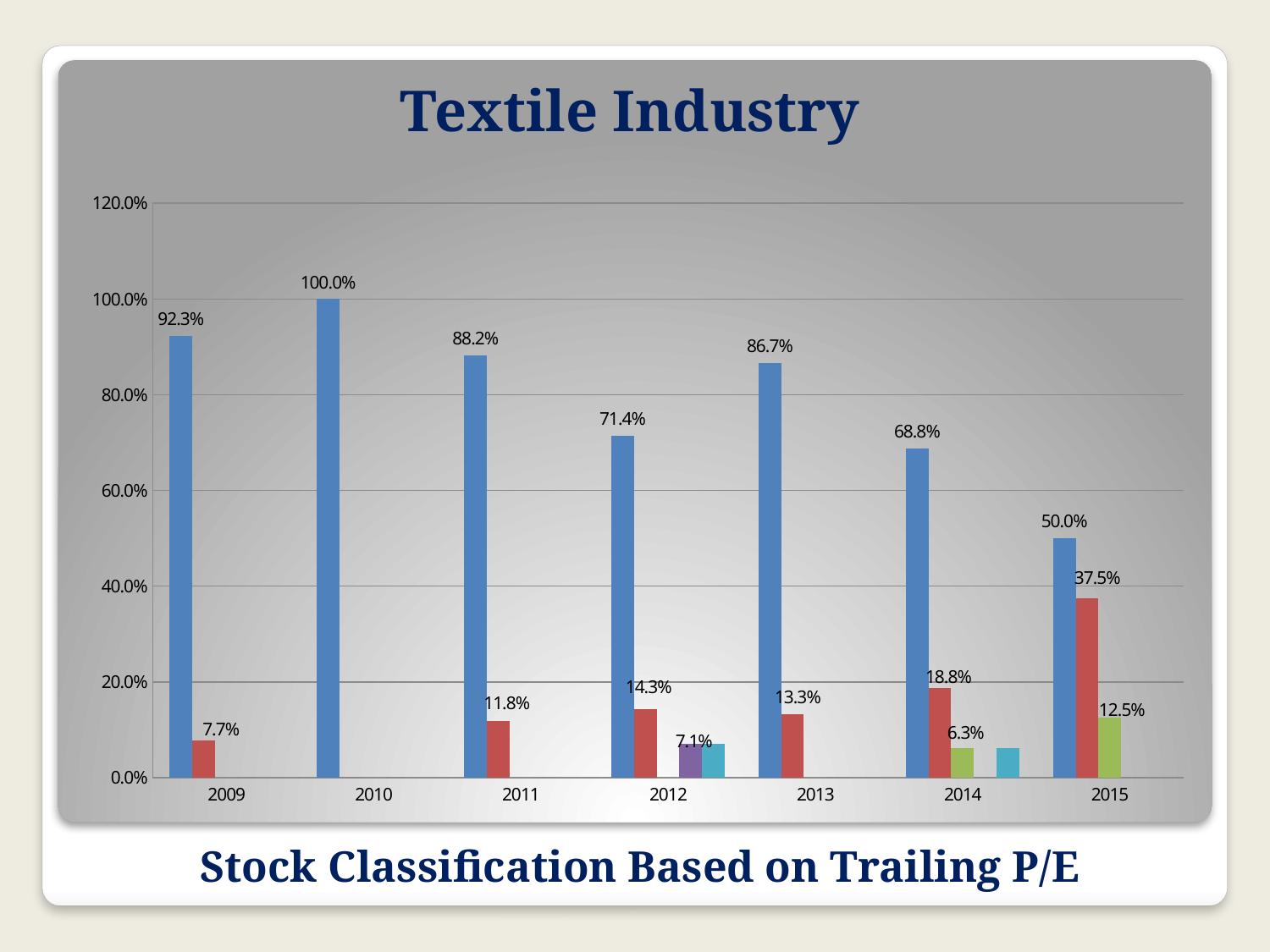
What is the title of the chart? Textile Industry Which is larger, the red bar in 2014 or the red bar in 2013? 2014 What kind of chart is shown on the slide? bar chart In which year is the blue bar lowest? 2015 What is the difference between the blue bar and the red bar in 2009? 84.6% What is the difference between the blue bar values for 2013 and 2014? 17.9% What is the value of the green bar for 2014? 6.3% In which year is the blue bar highest? 2010 How many years are shown on the x axis? 7 Is the value of the teal bar for 2014 greater or less than 20.0%? less What is the value of the red bar for 2015? 37.5% What is the value of the blue bar for 2010? 100.0%